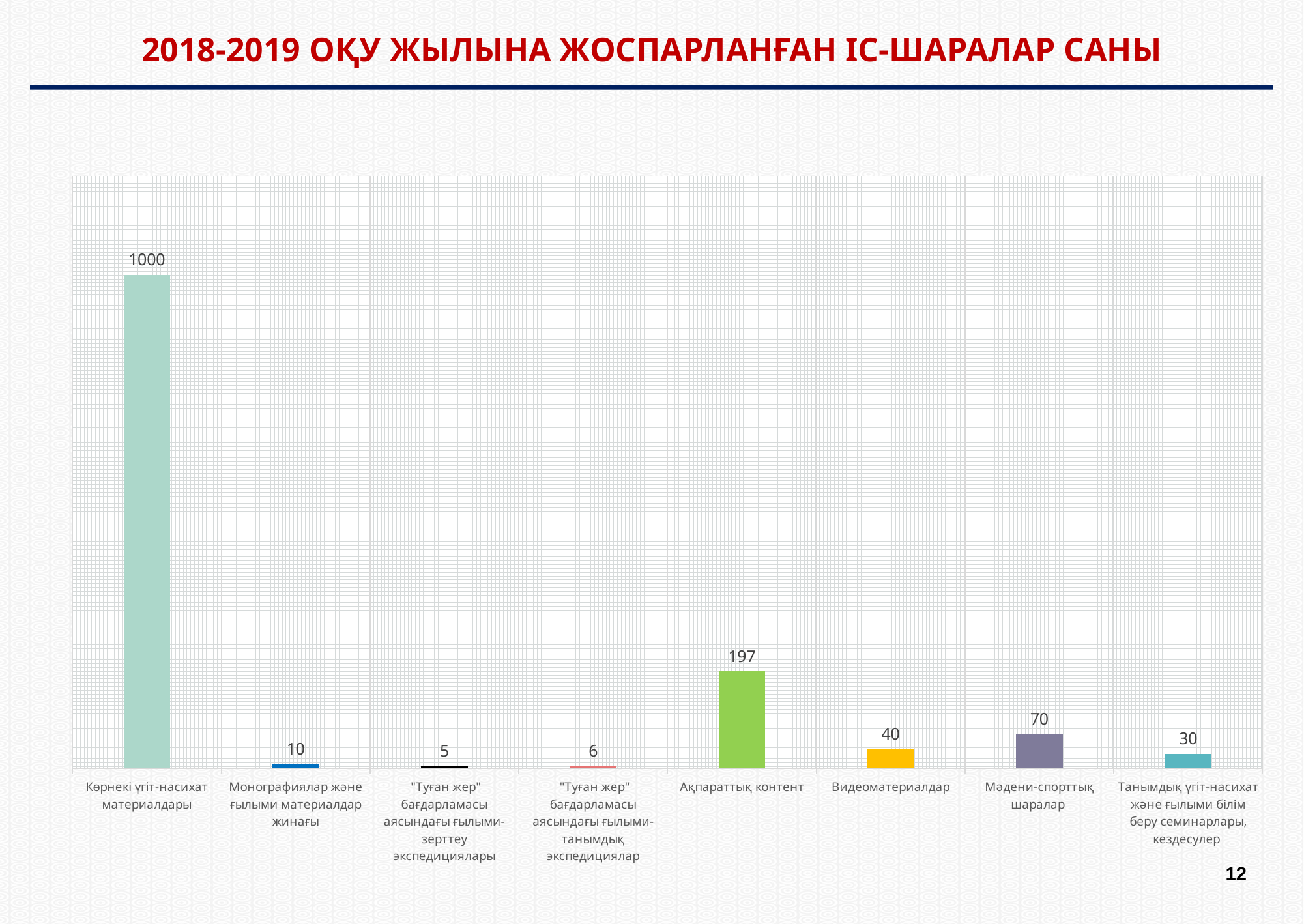
How many categories are shown in the chart? 8 What is the value for Ақпараттық контент? 197 What is the title of the slide? 2018-2019 ОҚУ ЖЫЛЫНА ЖОСПАРЛАНҒАН ІС-ШАРАЛАР САНЫ What is the value for Мәдени-спорттық шаралар? 70 What is the value for Видеоматериалдар? 40 Which is larger: the value for Мәдени-спорттық шаралар or the value for Танымдық үгіт-насихат және ғылыми білім беру семинарлары, кездесулер? Мәдени-спорттық шаралар What is the difference between the values for Ақпараттық контент and Видеоматериалдар? 157 What is the value for Көрнекі үгіт-насихат материалдары? 1000 Which category has the lowest value? "Туған жер" бағдарламасы аясындағы ғылыми-зерттеу экспедициялары Which category has the highest value? Көрнекі үгіт-насихат материалдары What type of chart is shown on the slide? Bar chart What is the value for Монографиялар және ғылыми материалдар жинағы? 10